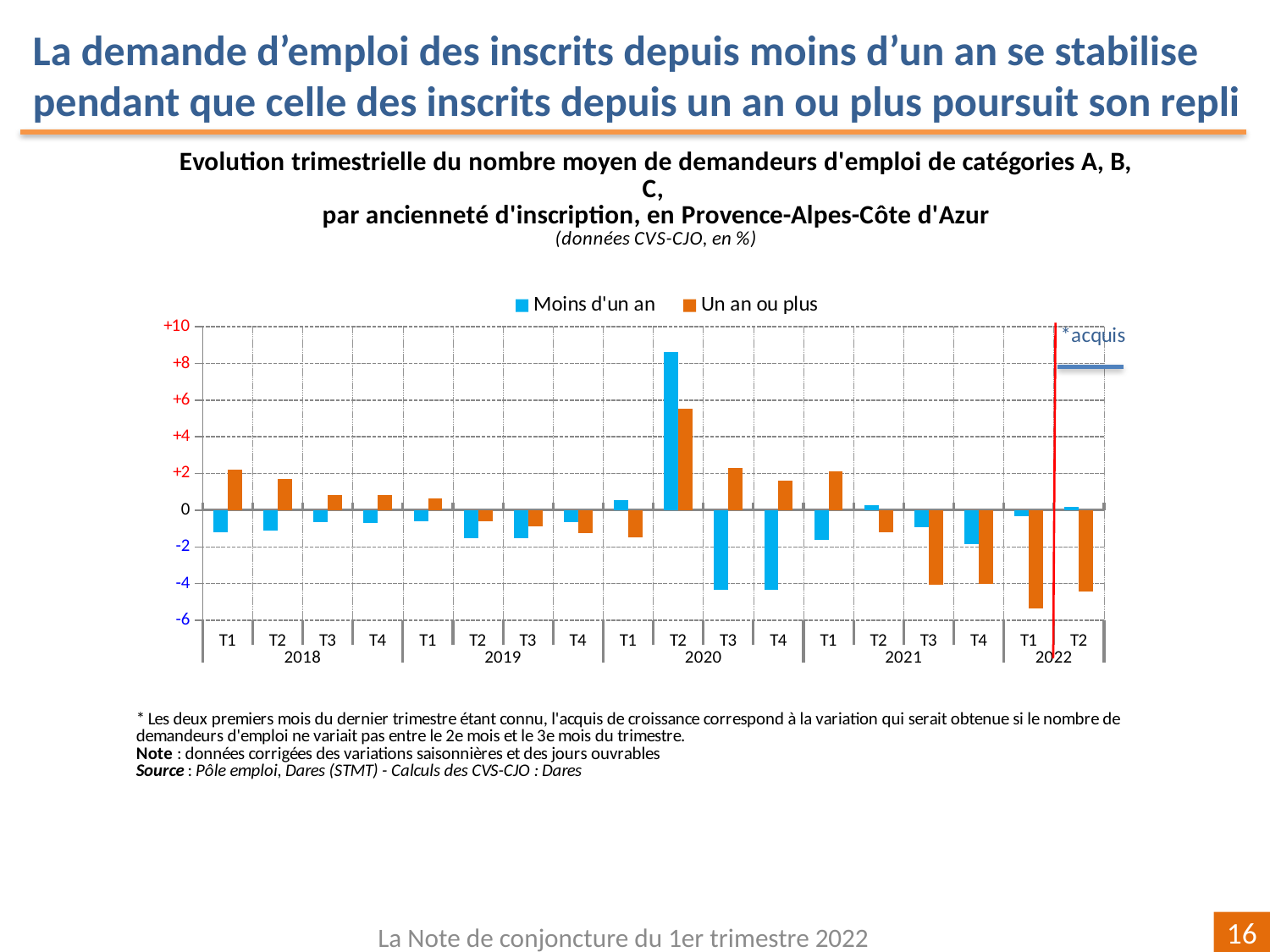
What does the red vertical line before T2 2022 mark? acquis Is the value for 'Moins d'un an' in T2 2020 greater or less than +8? greater In which quarter is the value for 'Un an ou plus' the highest? T2 2020 Is the value for 'Un an ou plus' in T2 2020 greater or less than +6? less What kind of chart is shown on the slide? bar chart In which quarter is the value for 'Un an ou plus' the lowest? T1 2022 In which quarter is the value for 'Moins d'un an' the highest? T2 2020 Is the value for 'Un an ou plus' in T1 2022 greater or less than -4? less In T2 2020, which series has the larger value, 'Moins d'un an' or 'Un an ou plus'? Moins d'un an How many quarters are plotted along the x axis? 18 Which colour represents the 'Un an ou plus' series? orange How many series does the legend list? 2